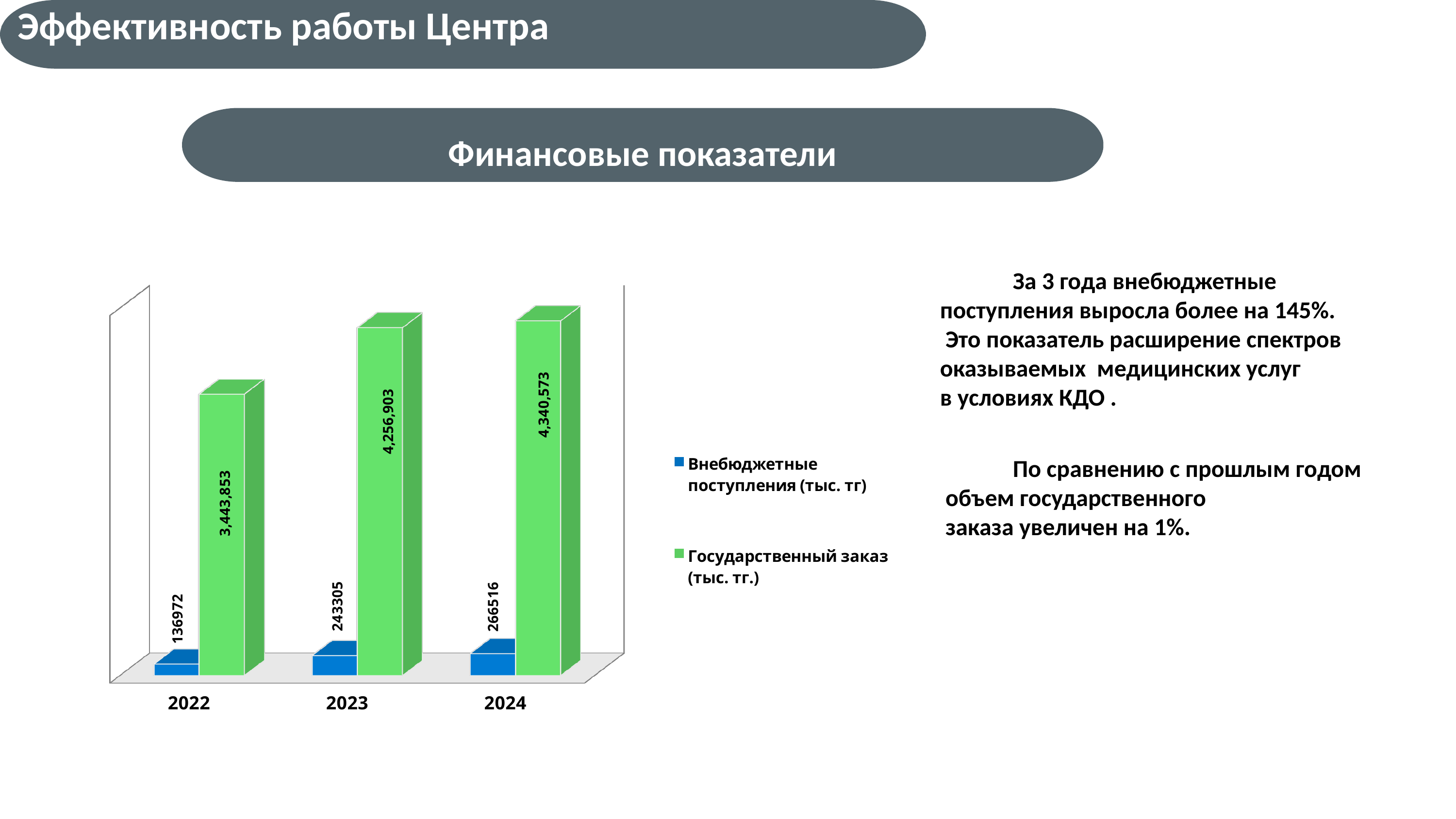
What is the value of Государственный заказ (тыс. тг.) for 2023? 4,256,903 What is the value of Внебюджетные поступления (тыс. тг) for 2024? 266516 What type of chart is shown on the slide? Bar chart Which is larger: Государственный заказ (тыс. тг.) in 2022 or in 2023? 2023 What is the value of Государственный заказ (тыс. тг.) for 2022? 3,443,853 How many series does the chart legend list? 2 In which year is Государственный заказ (тыс. тг.) the highest? 2024 In which year is Внебюджетные поступления (тыс. тг) the lowest? 2022 What is the difference between Внебюджетные поступления (тыс. тг) in 2023 and 2022? 106333 How many years are shown on the x axis of the chart? 3 What is the value of Внебюджетные поступления (тыс. тг) for 2022? 136972 Do the values of Внебюджетные поступления (тыс. тг) rise or fall from 2022 to 2024? Rise